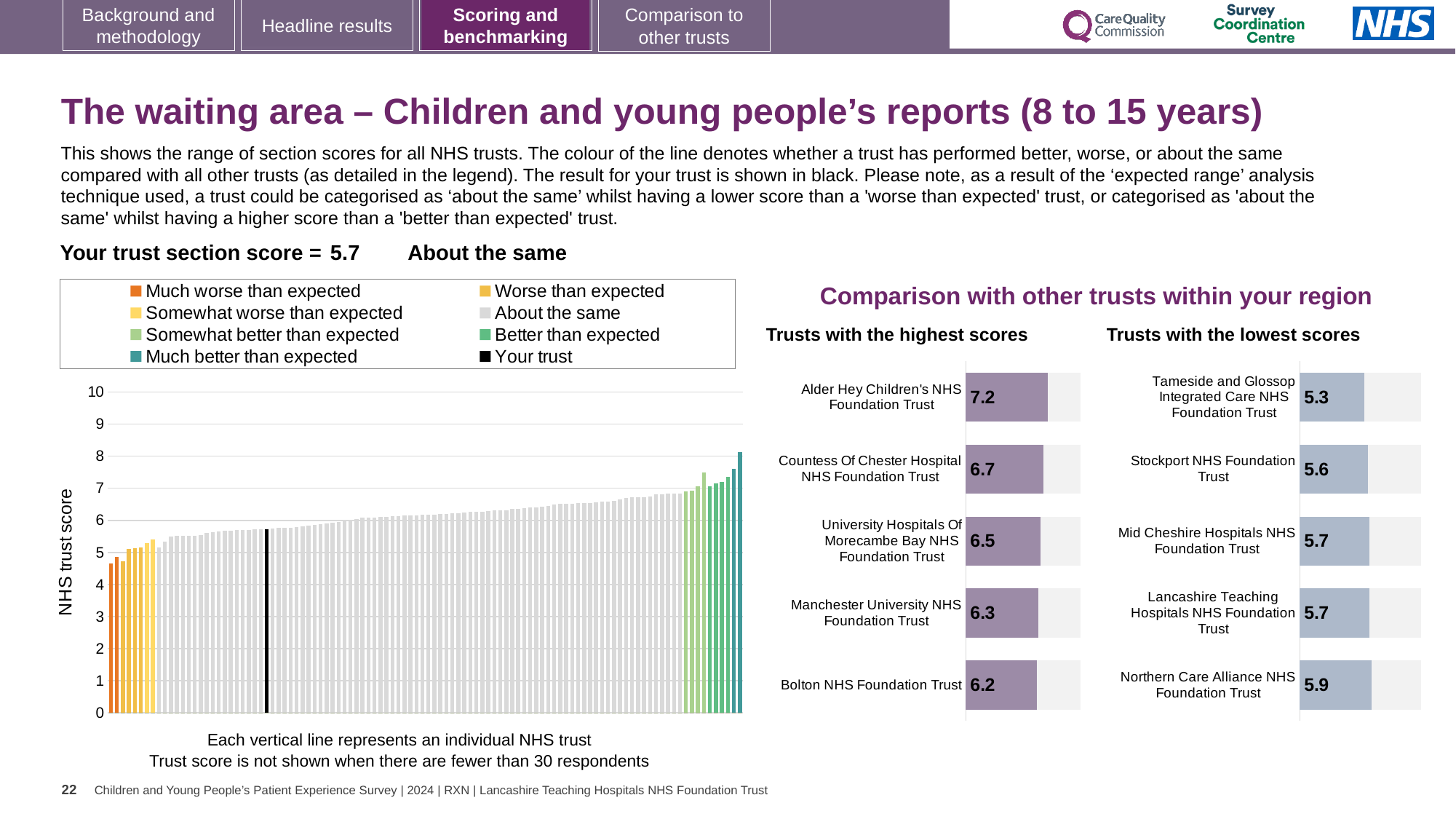
In the 'Trusts with the highest scores' chart, which trust has the lowest score shown? Bolton NHS Foundation Trust Which has the higher score: Countess Of Chester Hospital NHS Foundation Trust in the highest scores chart or Stockport NHS Foundation Trust in the lowest scores chart? Countess Of Chester Hospital NHS Foundation Trust How many entries does the legend above the large 'NHS trust score' chart list? 8 In the 'Trusts with the highest scores' chart, what is the difference between the scores of Alder Hey Children's NHS Foundation Trust and Bolton NHS Foundation Trust? 1.0 In the 'Trusts with the lowest scores' chart, which trust has the highest score shown? Northern Care Alliance NHS Foundation Trust In the large 'NHS trust score' chart on the left, do the bar values rise or fall from left to right? rise In the large 'NHS trust score' chart on the left, is the value of the leftmost (lowest) bar greater or less than 5? less In the 'Trusts with the lowest scores' chart, what is the score for Tameside and Glossop Integrated Care NHS Foundation Trust? 5.3 In the large 'NHS trust score' chart on the left, what is the score of the black bar representing your trust? 5.7 In the 'Trusts with the highest scores' chart, what is the score for Alder Hey Children's NHS Foundation Trust? 7.2 How many trusts are listed in the 'Trusts with the highest scores' chart? 5 In the 'Trusts with the lowest scores' chart, what is the difference between the scores of Northern Care Alliance NHS Foundation Trust and Tameside and Glossop Integrated Care NHS Foundation Trust? 0.6